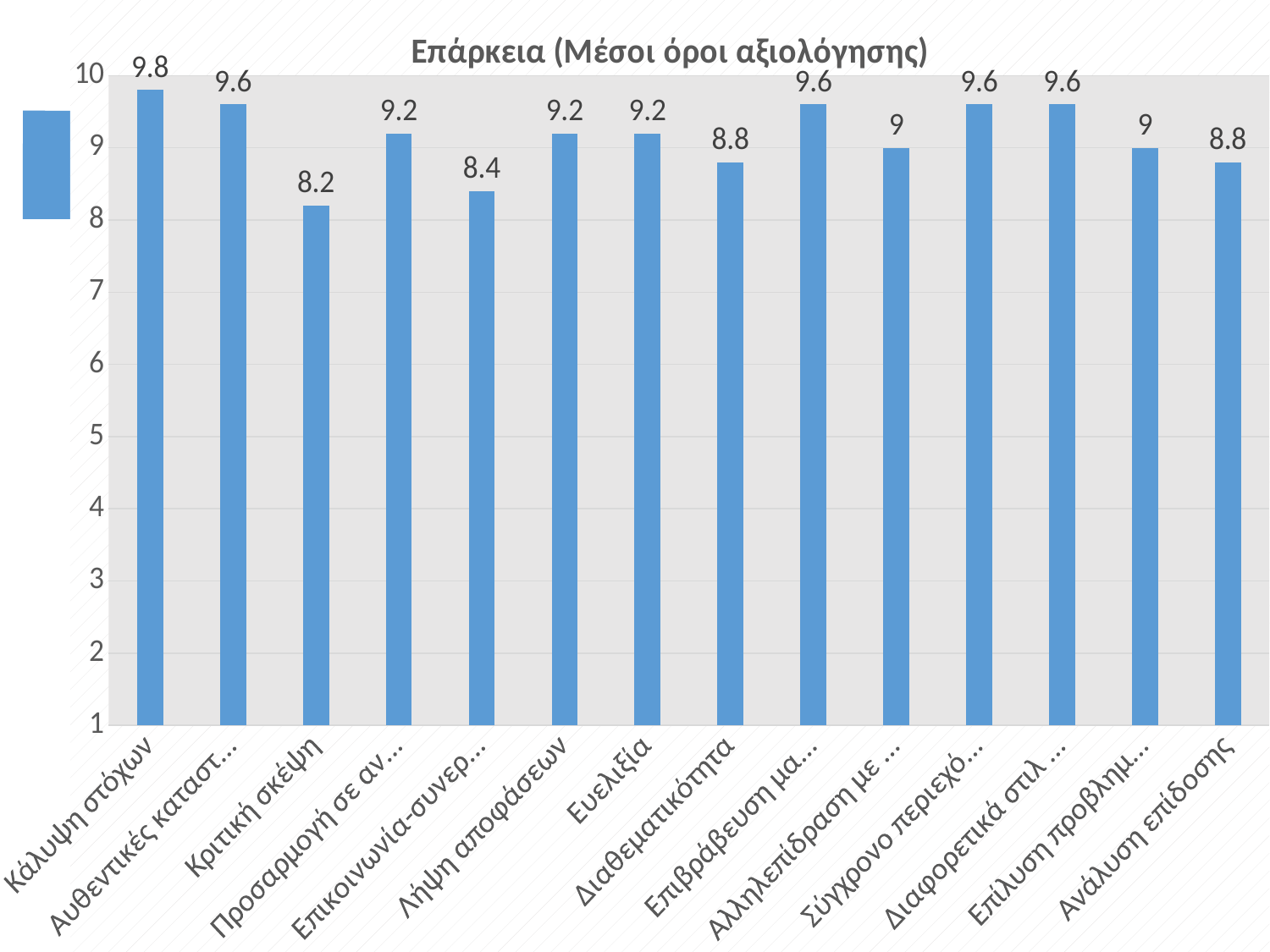
What is the value for Κάλυψη στόχων? 9.8 What kind of chart is shown on the slide? bar chart What is the value for Κριτική σκέψη? 8.2 How many categories are shown on the chart? 14 What is the title of the chart? Επάρκεια (Μέσοι όροι αξιολόγησης) Is the value for Κριτική σκέψη greater or less than 9? less Which is larger, the value for Λήψη αποφάσεων or the value for Διαθεματικότητα? Λήψη αποφάσεων Which category has the lowest value? Κριτική σκέψη What is the value for Ευελιξία? 9.2 What is the difference between the values for Κάλυψη στόχων and Κριτική σκέψη? 1.6 What is the value for Ανάλυση επίδοσης? 8.8 Which category has the highest value? Κάλυψη στόχων